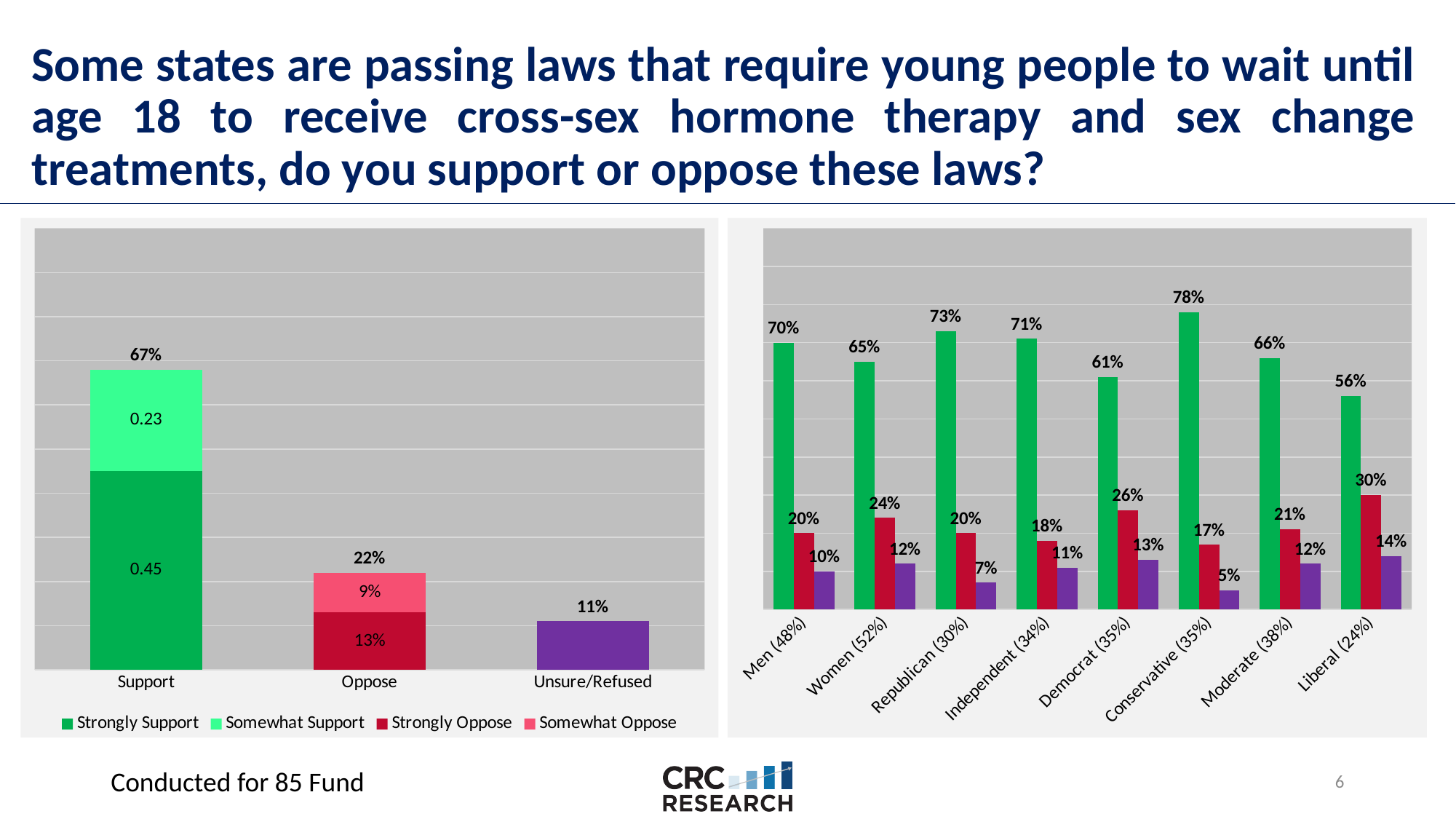
In the right chart, how many categories are shown on the x axis? 8 In the left chart, what value is printed for the Strongly Support segment of the Support bar? 0.45 In the left chart, how many series does the legend list? 4 In the left chart, what is the total value shown for the Support bar? 67% In the right chart, which category has the lowest purple bar? Conservative (35%) In the right chart, is the red bar for Women (52%) larger or smaller than the red bar for Men (48%)? larger In the right chart, what is the difference between the green bars for Republican (30%) and Democrat (35%)? 12% In the left chart, what value is printed for the Somewhat Oppose segment of the Oppose bar? 9% In the right chart, which category has the highest green bar? Conservative (35%) In the left chart, what is the value for Unsure/Refused? 11% In the left chart, what is the difference between the Strongly Oppose and Somewhat Oppose segments of the Oppose bar? 4% In the right chart, what is the value of the green bar for Liberal (24%)? 56%